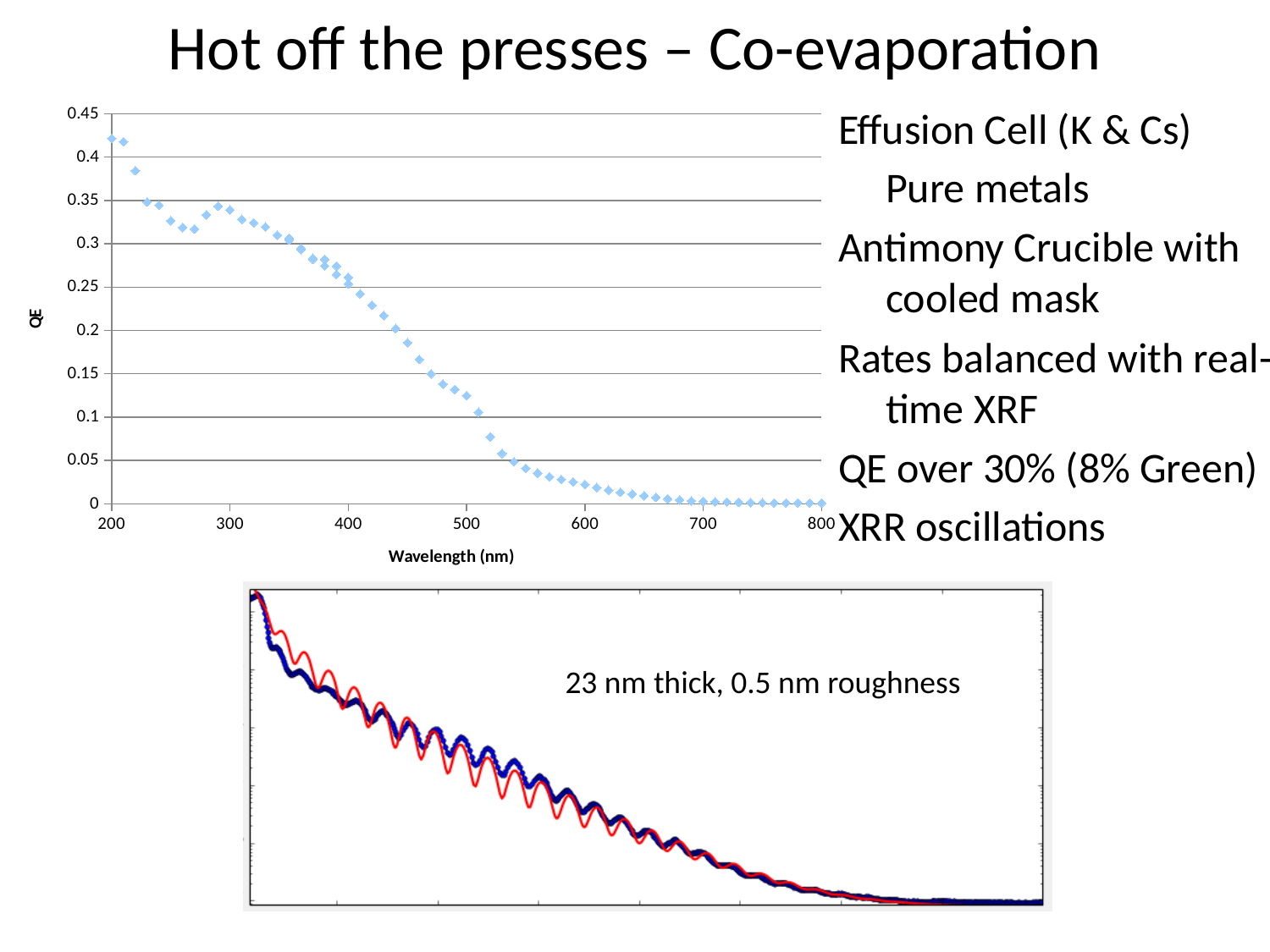
In the top-left chart, at which end of the wavelength range is QE highest, 200 nm or 800 nm? 200 nm In the top-left chart, is the QE value at 200 nm greater or less than 0.4? greater In the top-left chart, what is the title of the x axis? Wavelength (nm) In the top-left chart, is the QE value at 700 nm greater or less than 0.05? less In the top-left chart, what is the highest value shown on the QE axis? 0.45 In the top-left chart, what is the title of the y axis? QE In the top-left chart, which is larger, the QE at 300 nm or the QE at 500 nm? 300 nm In the top-left chart, is the QE value at 300 nm greater or less than 0.3? greater What kind of chart is the top-left chart of QE against wavelength? scatter chart In the top-left chart, do the QE values generally rise or fall as wavelength increases from 200 nm to 800 nm? fall